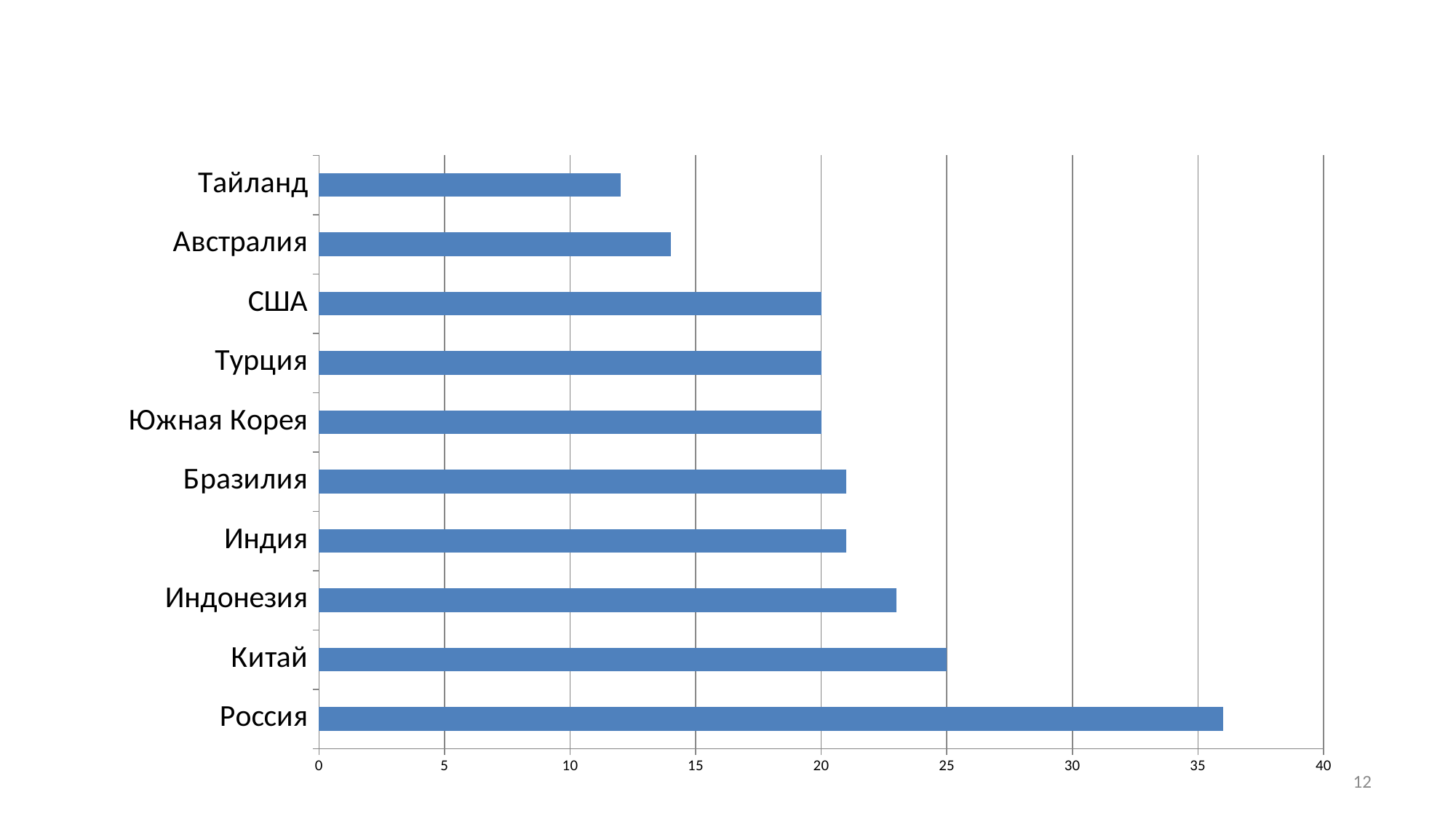
Is the value for Россия greater or less than 35? greater Which has a larger value, Китай or Индонезия? Китай How many countries are shown in the chart? 10 What is the value for Южная Корея? 20 Which country has the highest value in the chart? Россия Is the value for Австралия greater or less than 15? less Is the value for Таиланд greater or less than 10? greater What is the value for США? 20 Which country has the lowest value in the chart? Тайланд What type of chart is shown on the slide? bar chart What is the value for Китай? 25 What is the difference between the values for Китай and Турция? 5